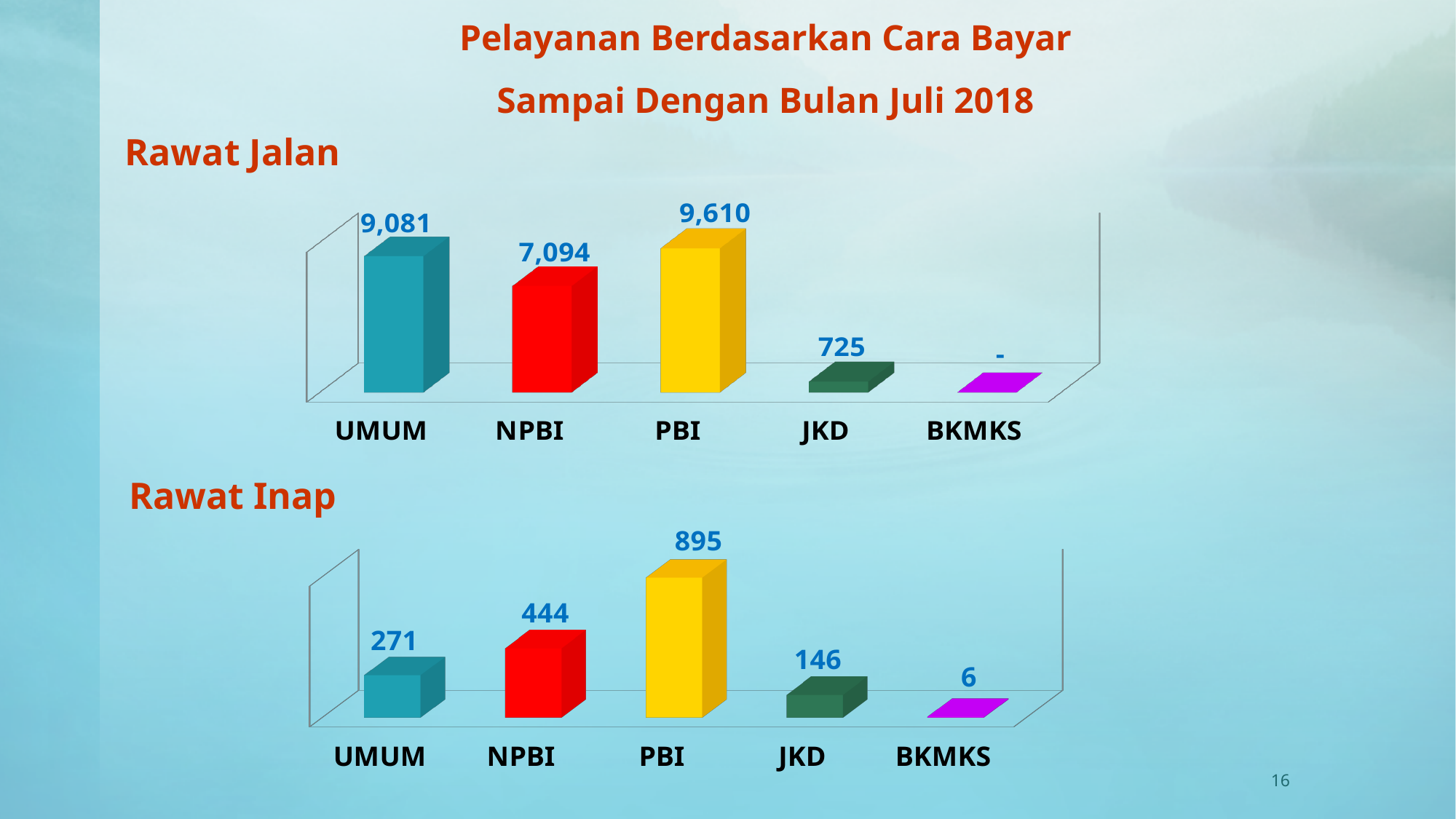
In the Rawat Jalan chart, what is the value for JKD? 725 In the Rawat Inap chart, what is the difference between PBI and UMUM? 624 In the Rawat Inap chart, which category has the lowest value? BKMKS In the Rawat Jalan chart, what is the value for UMUM? 9,081 In the Rawat Jalan chart, which is larger, UMUM or NPBI? UMUM In the Rawat Jalan chart, which category has the highest value? PBI How many categories are shown in the Rawat Inap chart? 5 In the Rawat Inap chart, what is the value for BKMKS? 6 In the Rawat Inap chart, what is the value for NPBI? 444 What colour is the PBI bar in the Rawat Inap chart? Yellow In the Rawat Jalan chart, what is the difference between PBI and NPBI? 2,516 What kind of chart is the Rawat Jalan chart? Bar chart